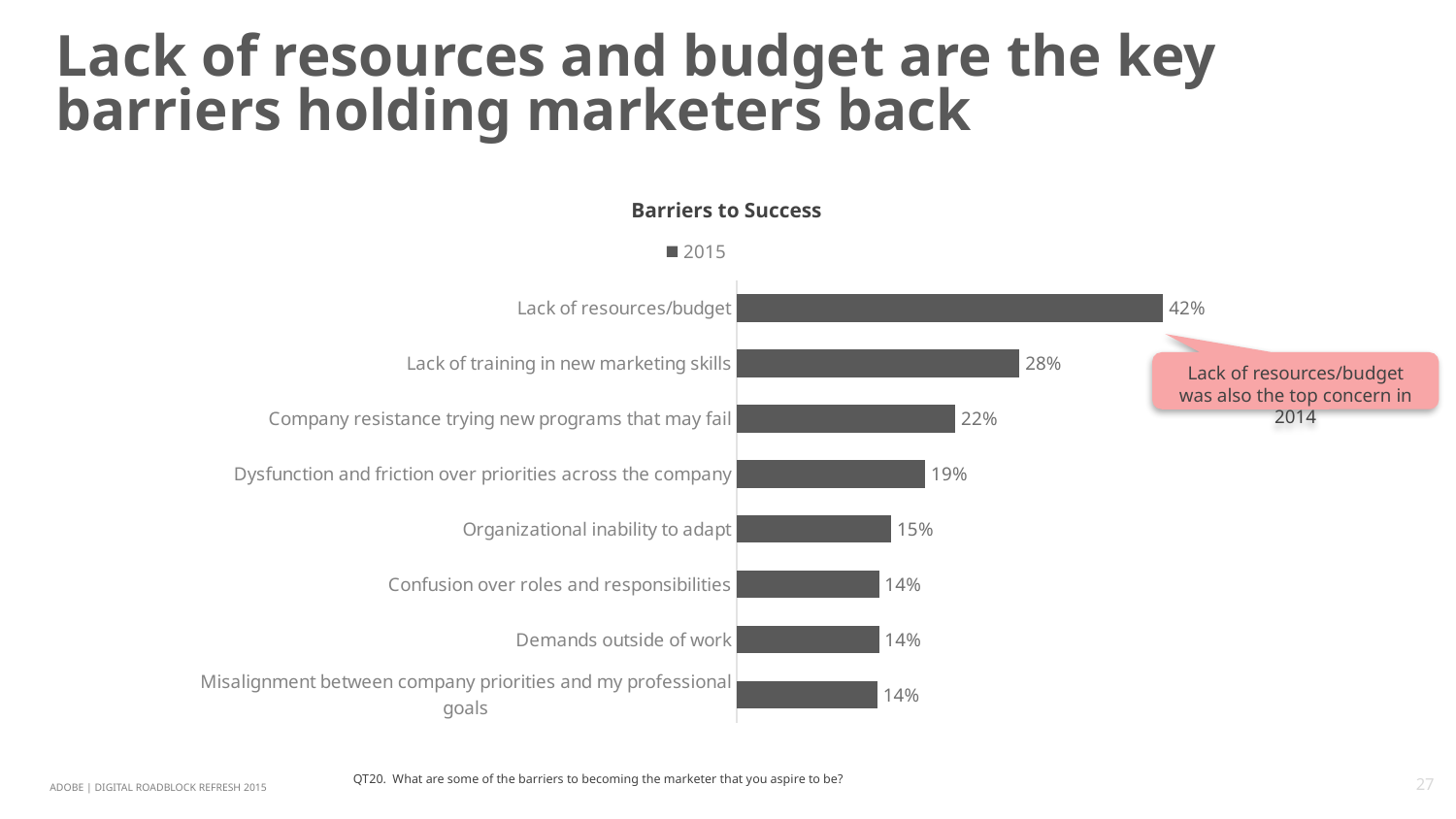
What is the difference between Company resistance trying new programs that may fail and Organizational inability to adapt? 7% What is the title of the chart? Barriers to Success How many series does the legend list? 1 Which is larger: Company resistance trying new programs that may fail or Dysfunction and friction over priorities across the company? Company resistance trying new programs that may fail What is the value for Dysfunction and friction over priorities across the company? 19% Which barrier has the highest value? Lack of resources/budget What kind of chart is shown? Bar chart How many barriers are shown in the chart? 8 What is the value for Organizational inability to adapt? 15% What is the value for Lack of training in new marketing skills? 28% What is the difference between Lack of resources/budget and Lack of training in new marketing skills? 14% What is the value for Lack of resources/budget? 42%